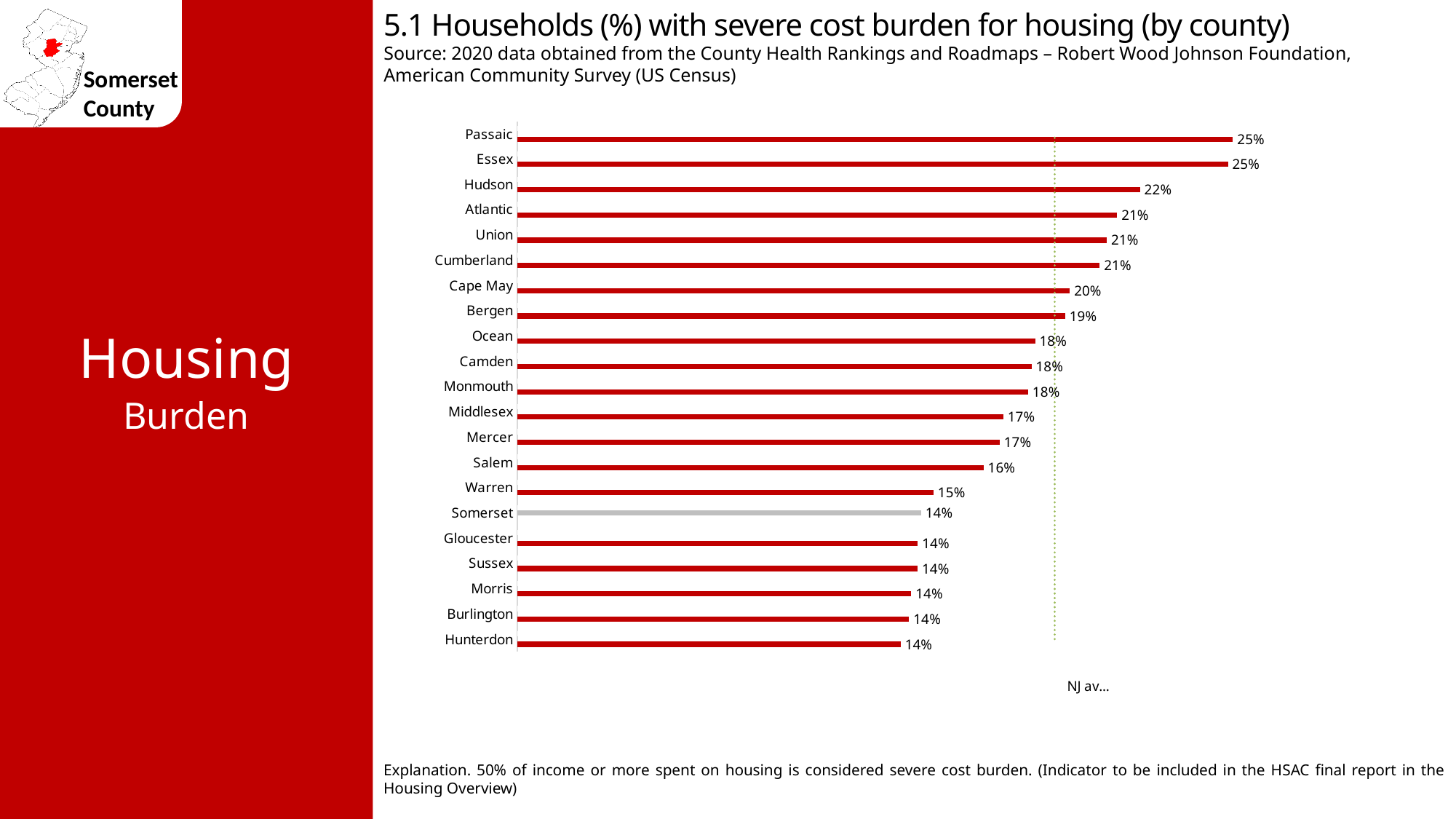
How many counties are plotted on the chart? 21 What kind of chart is shown on the slide? Bar chart Which county's bar is coloured grey instead of red? Somerset Which has a higher value, Cape May or Middlesex? Cape May Which two counties share the highest value on the chart? Passaic and Essex What is the value shown for Bergen County? 19% What is the value shown for Salem County? 16% What is the difference between the values for Passaic and Warren? 10 percentage points What percentage of households in Passaic County have a severe housing cost burden? 25% What is the value shown for Somerset County? 14% What is the difference between the values for Hudson and Somerset? 8 percentage points What is the value shown for Hudson County? 22%